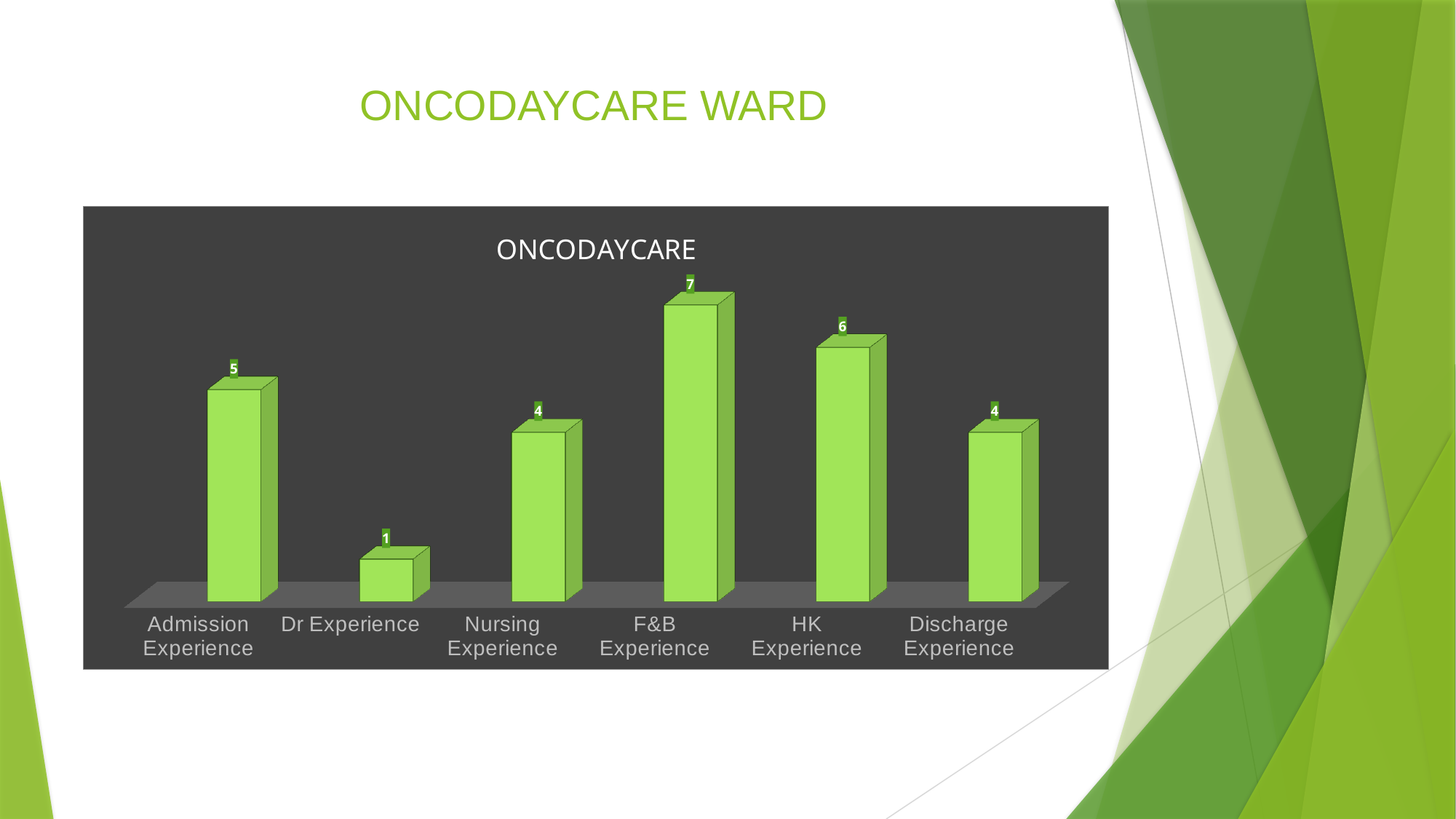
What is the title of the chart? ONCODAYCARE What is the value for Admission Experience? 5 What is the value for HK Experience? 6 Which category has the highest value? F&B Experience What is the difference between the values for F&B Experience and Dr Experience? 6 How many categories are shown on the chart? 6 Which is larger, the value for Admission Experience or the value for Nursing Experience? Admission Experience What kind of chart is shown on the slide? Bar chart Which category has the lowest value? Dr Experience What is the value for F&B Experience? 7 What is the value for Dr Experience? 1 What is the difference between the values for HK Experience and Admission Experience? 1